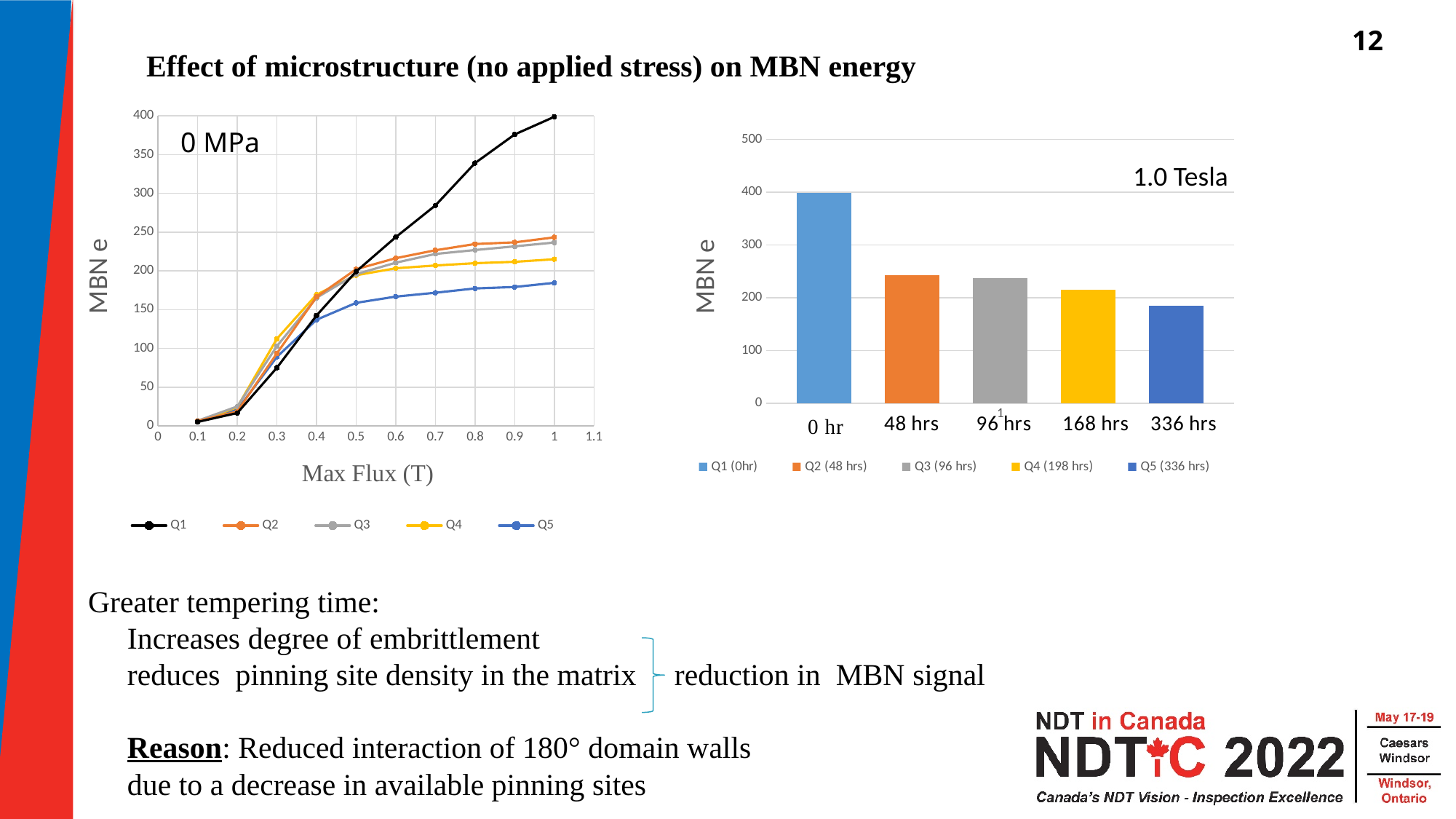
In the right chart (1.0 Tesla), which category has the highest bar? 0 hr In the left chart (0 MPa), which series has the highest value at a max flux of 1 T? Q1 In the left chart (0 MPa), do the series values rise or fall as max flux increases from 0.1 to 1 T? rise In the right chart (1.0 Tesla), how many bars are plotted? 5 In the left chart (0 MPa), how many series does the legend list? 5 In the left chart (0 MPa), is the value of Q5 at a max flux of 1 T greater or less than 200? less In the right chart (1.0 Tesla), is the value for 0 hr greater or less than 300? greater In the left chart (0 MPa), which series has the lowest value at a max flux of 1 T? Q5 What is the x-axis title of the left chart (0 MPa)? Max Flux (T) What kind of chart is the left chart labelled 0 MPa? line chart What kind of chart is the right chart labelled 1.0 Tesla? bar chart In the right chart (1.0 Tesla), which category has the lowest bar? 336 hrs